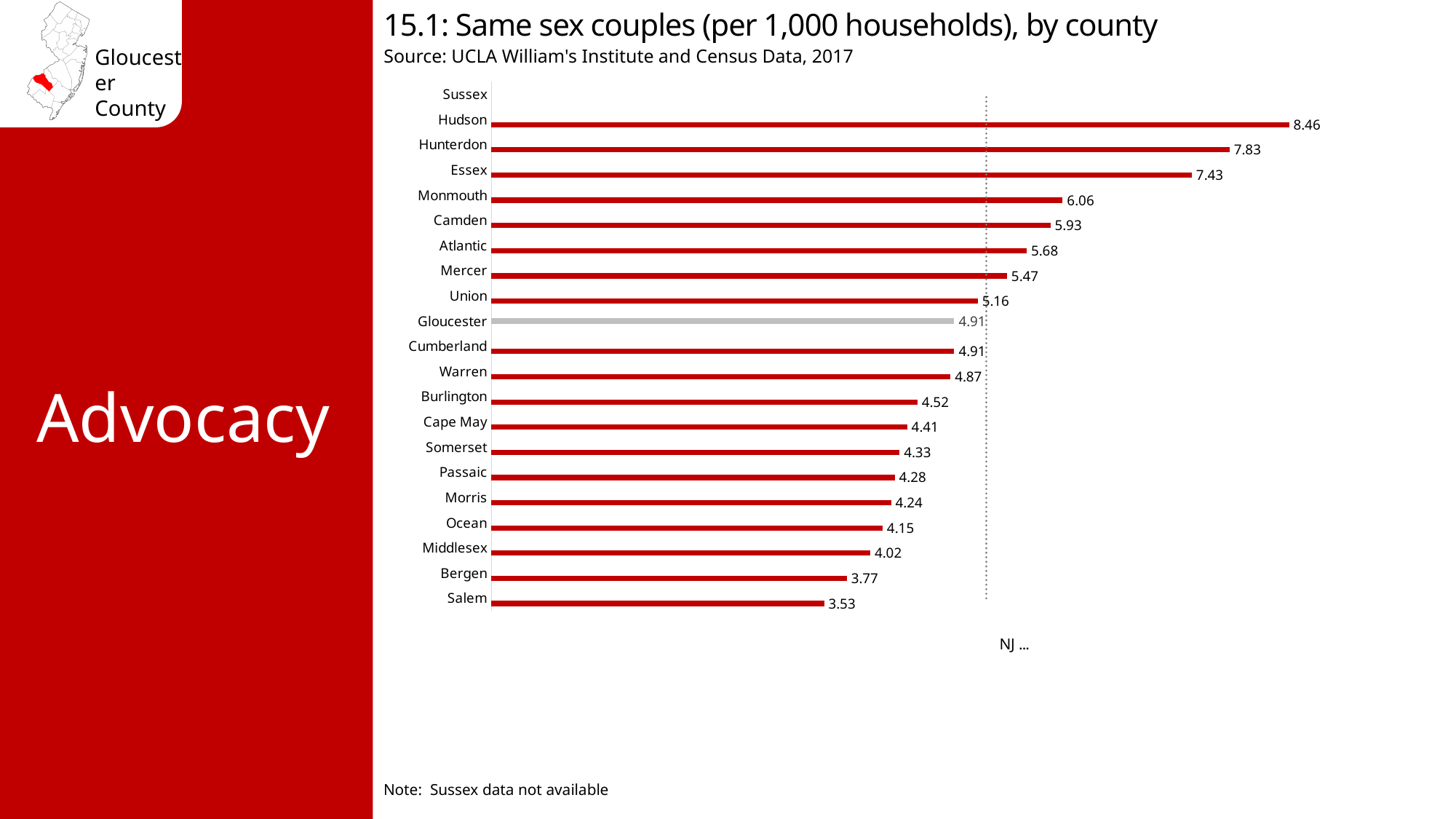
What is the difference between the values for Hudson and Gloucester? 3.55 Among counties with data shown, which county has the lowest value? Salem Which county's bar is shown in grey rather than red? Gloucester What is the difference between the values for Hudson and Salem? 4.93 Which county has the highest number of same sex couples per 1,000 households? Hudson What is the value for Salem County? 3.53 What is the value for Gloucester County? 4.91 What is the value for Hudson County? 8.46 How many counties are listed on the chart's axis? 21 What type of chart is shown on the slide? Bar chart Which has a larger value, Monmouth or Camden? Monmouth According to the note on the slide, which county's data is not available? Sussex